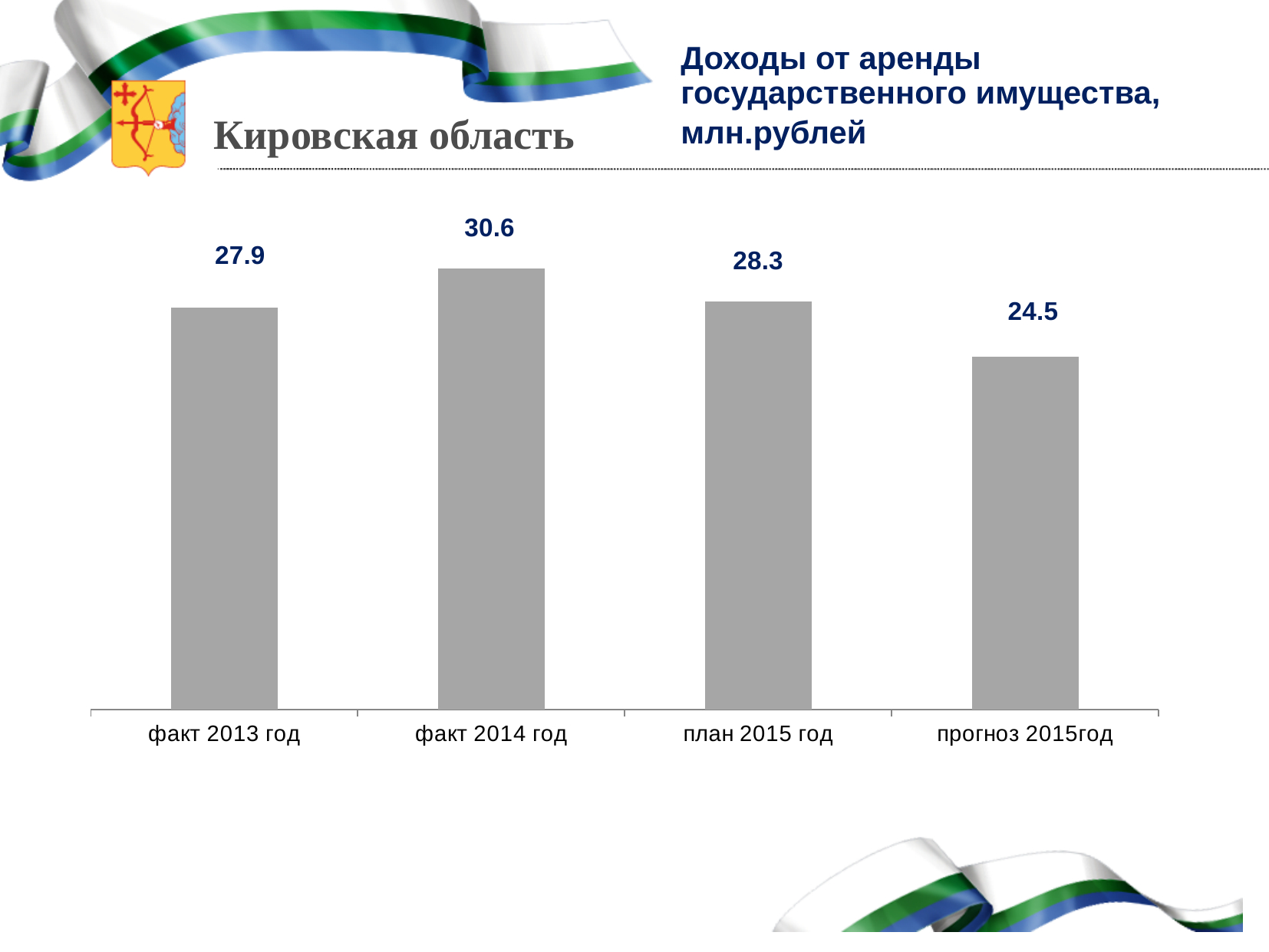
What is the value for факт 2013 год? 27.9 How many categories are shown on the chart? 4 What is the difference between the values for план 2015 год and факт 2013 год? 0.4 Which category has the lowest value? прогноз 2015год Which is larger, the value for факт 2014 год or the value for план 2015 год? факт 2014 год What is the difference between the values for факт 2014 год and прогноз 2015год? 6.1 What is the value for прогноз 2015год? 24.5 What is the title of the chart? Доходы от аренды государственного имущества, млн.рублей Which category has the highest value? факт 2014 год What is the value for факт 2014 год? 30.6 What is the value for план 2015 год? 28.3 What kind of chart is shown on the slide? bar chart